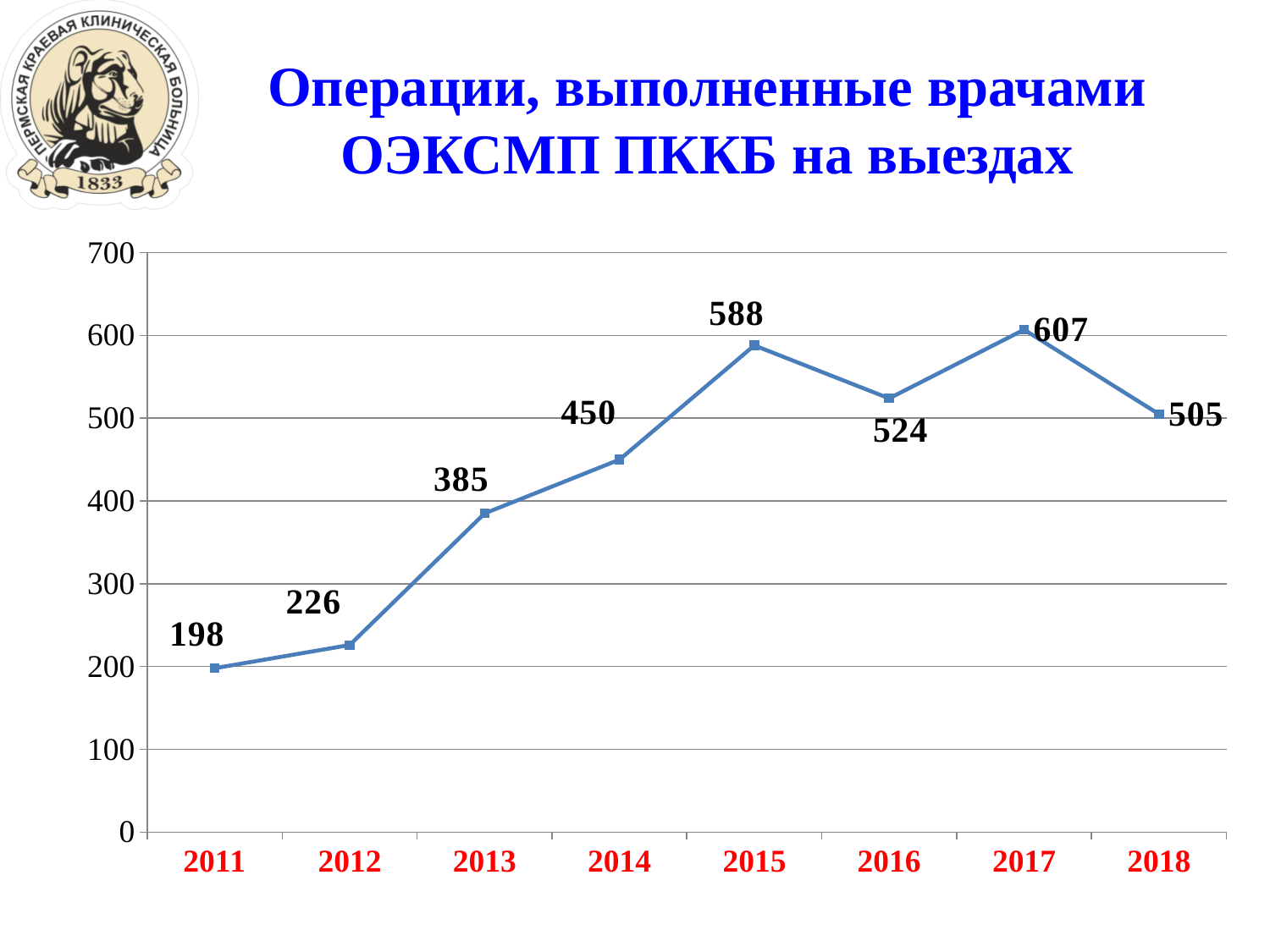
What is the value for 2011? 198 Which year has the highest value? 2017 Do the values rise or fall from 2011 to 2015? rise What is the value for 2015? 588 What is the value for 2018? 505 What is the difference between the values for 2014 and 2013? 65 What is the difference between the values for 2017 and 2016? 83 Is the value for 2013 greater or less than 400? less Which year has the lowest value? 2011 What kind of chart is this? line chart How many years are shown on the x axis? 8 Which is larger, the value for 2015 or the value for 2018? 2015